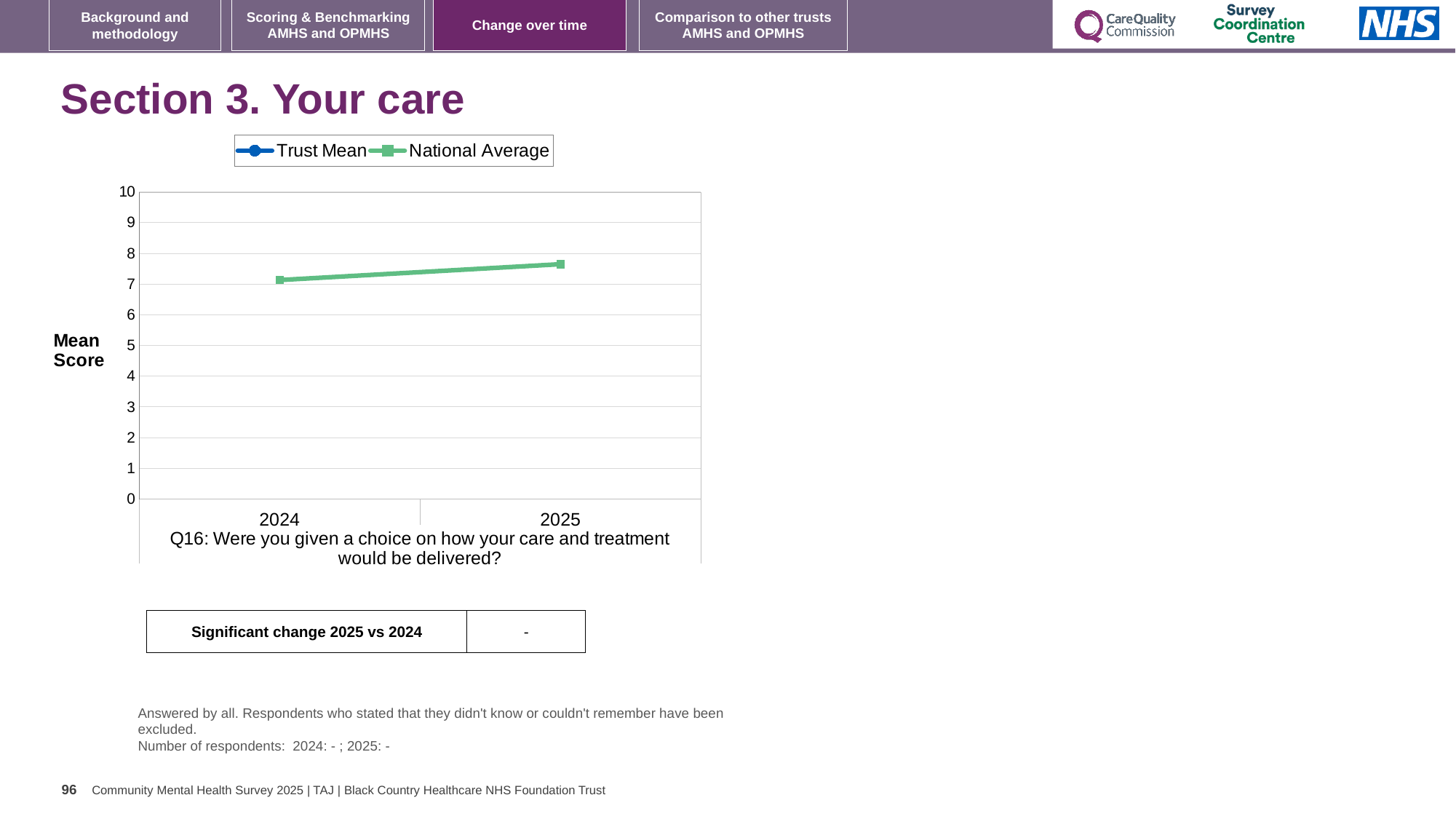
How many years are shown on the x axis of the chart? 2 Is the National Average value for 2025 greater or less than 7? greater How many series does the chart legend list? 2 Which series in the legend is shown in green? National Average What is the label on the y axis of the chart? Mean Score Does the National Average line rise or fall from 2024 to 2025? rise What is the highest value shown on the y axis of the chart? 10 Which year has the higher National Average value, 2024 or 2025? 2025 Is the National Average value for 2024 greater or less than 8? less What kind of chart is shown on the slide? line chart Is the National Average value for 2025 greater or less than 8? less